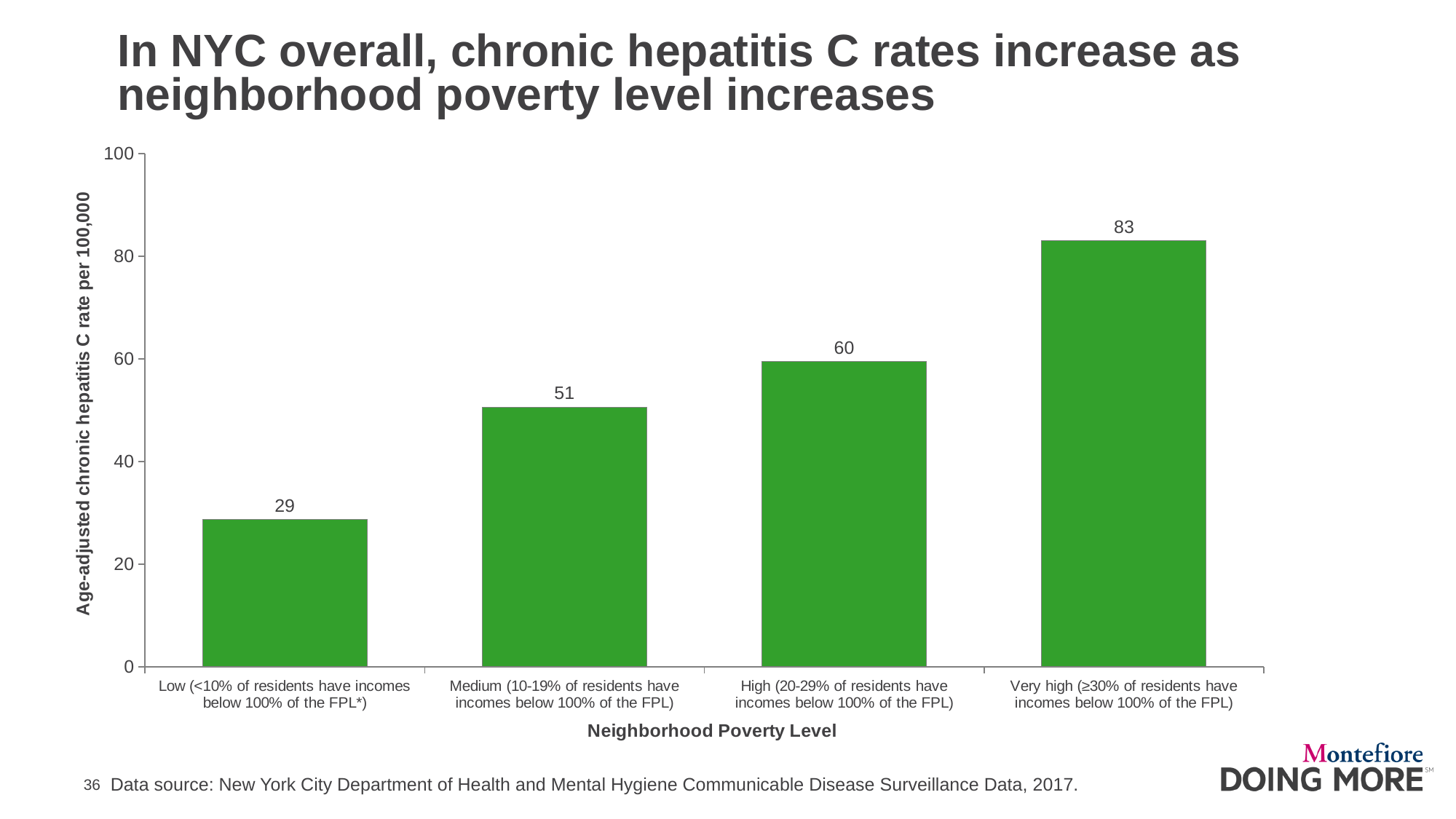
Do the chronic hepatitis C rates rise or fall as neighborhood poverty level increases from Low to Very high? Rise What is the age-adjusted chronic hepatitis C rate per 100,000 for the Very high neighborhood poverty level? 83 What is the age-adjusted chronic hepatitis C rate per 100,000 for the High neighborhood poverty level? 60 What is the age-adjusted chronic hepatitis C rate per 100,000 for the Low neighborhood poverty level? 29 What is the difference in chronic hepatitis C rate between the High and Medium poverty levels? 9 What is the age-adjusted chronic hepatitis C rate per 100,000 for the Medium neighborhood poverty level? 51 What kind of chart is shown on the slide? Bar chart Which has a higher chronic hepatitis C rate, the Medium or the High poverty level? High Which neighborhood poverty level has the lowest chronic hepatitis C rate? Low Which neighborhood poverty level has the highest chronic hepatitis C rate? Very high How many neighborhood poverty level categories are shown in the chart? 4 What is the difference in chronic hepatitis C rate between the Very high and Low poverty levels? 54